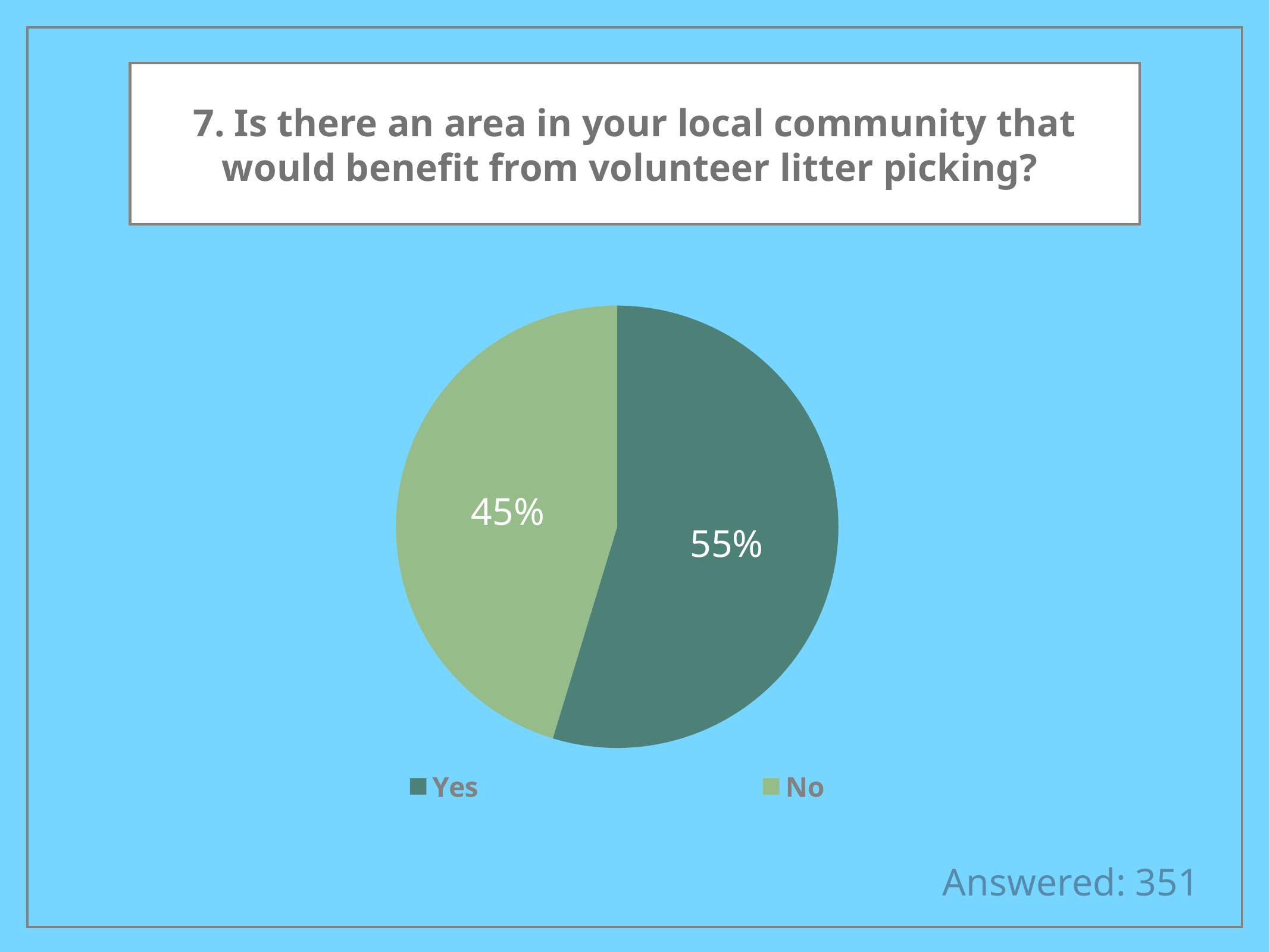
Which slice is the smallest? No What kind of chart is shown on the slide? Pie chart What share of the pie is labelled Yes? 55% Which slice is the largest? Yes What is the difference in percentage points between the Yes and No slices? 10 What share of the pie is labelled No? 45% What is the title of the chart? 7. Is there an area in your local community that would benefit from volunteer litter picking? Which is larger, the Yes slice or the No slice? Yes How many people answered the question, according to the slide? 351 How many slices does the pie chart have? 2 How many entries does the legend list? 2